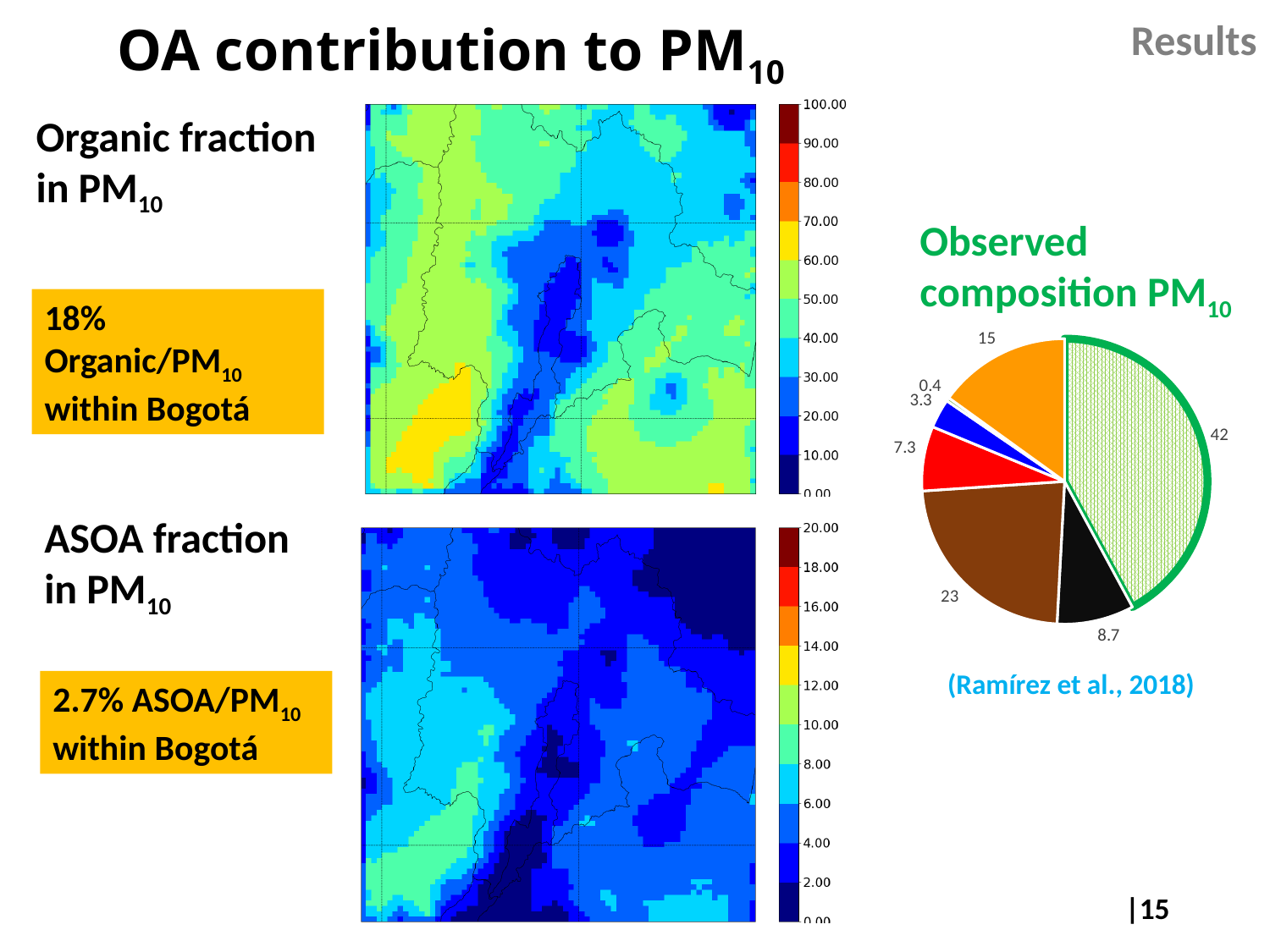
In the 'Observed composition PM10' pie chart, what is the value of the orange slice? 15 In the 'Observed composition PM10' pie chart, what is the value of the largest slice (the green hatched one)? 42 What kind of chart is the 'Observed composition PM10' chart on the right of the slide? pie chart In the 'Observed composition PM10' pie chart, what is the difference between the green hatched slice (42) and the brown slice (23)? 19 In the 'Observed composition PM10' pie chart, what is the value of the brown slice? 23 In the 'Observed composition PM10' pie chart, how many slices are there? 7 In the 'Observed composition PM10' pie chart, what is the value of the smallest slice? 0.4 What is the maximum value on the colour scale of the top map ('Organic fraction in PM10')? 100.00 In the 'Observed composition PM10' pie chart, which slice is larger: the orange slice or the black slice? the orange slice In the 'Observed composition PM10' pie chart, what is the value of the black slice? 8.7 What is the source citation shown below the 'Observed composition PM10' pie chart? (Ramírez et al., 2018) In the 'Observed composition PM10' pie chart, what is the value of the red slice? 7.3